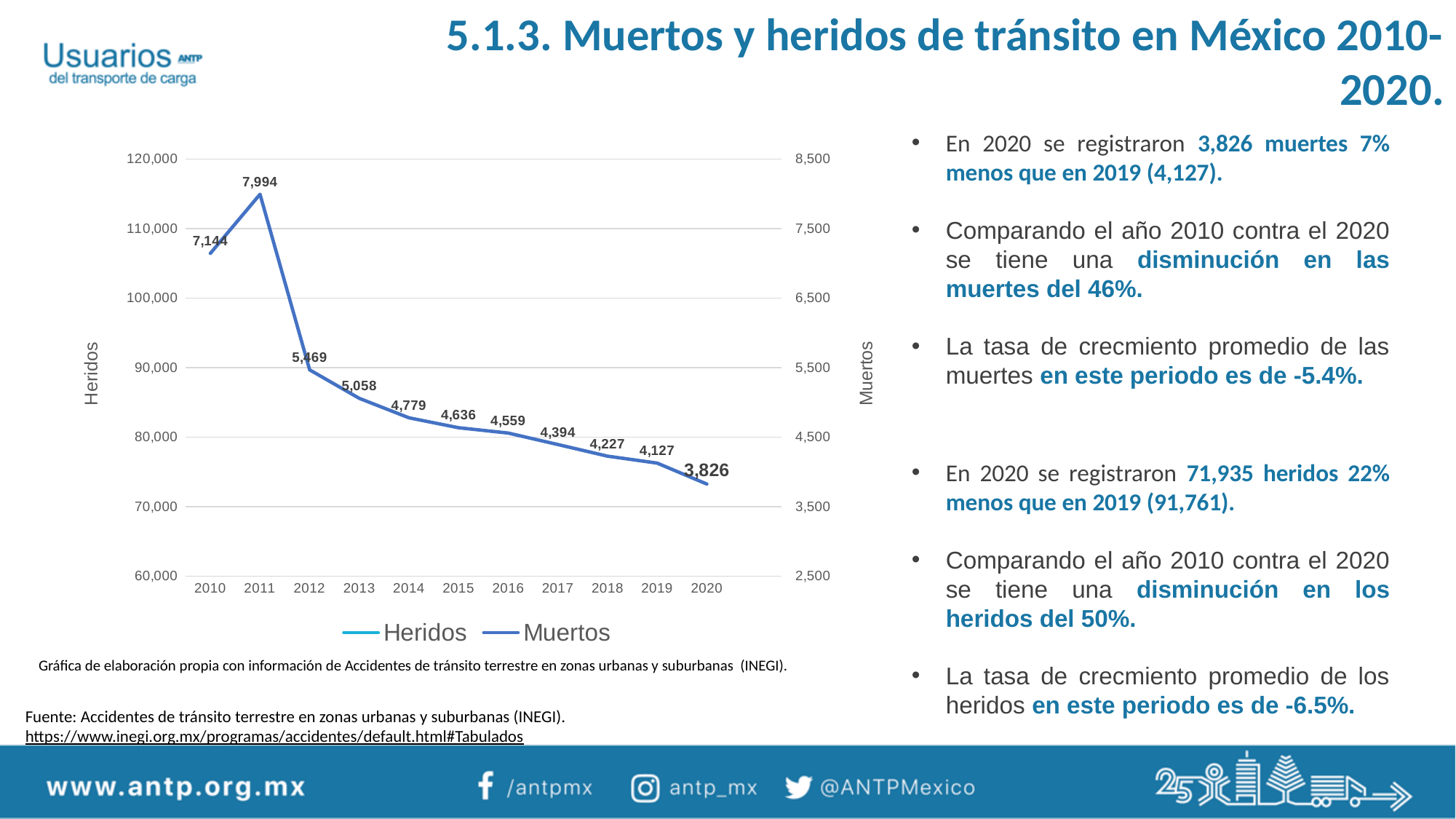
What is the label of the right-hand vertical axis? Muertos What is the value of Muertos for 2020? 3,826 What is the difference between the Muertos values for 2019 and 2020? 301 What type of chart is shown on the slide? line chart In which year is the Muertos value lowest? 2020 Which year has a larger Muertos value, 2010 or 2012? 2010 Do the Muertos values rise or fall from 2011 to 2020? fall How many series does the chart legend list? 2 What is the value of Muertos for 2015? 4,636 In which year is the Muertos value highest? 2011 How many years are shown on the x axis? 11 What is the value of Muertos for 2011? 7,994